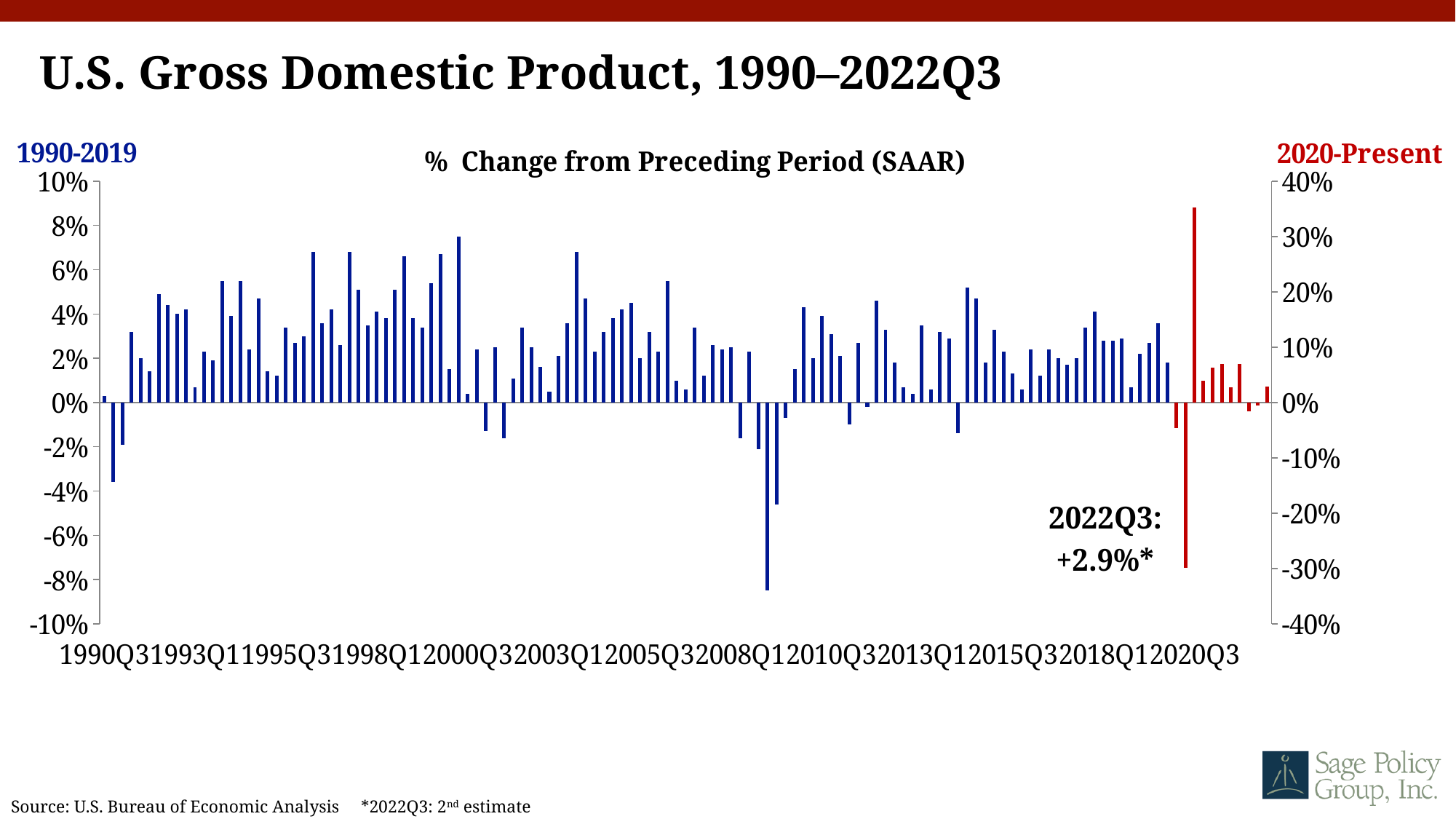
What is the GDP % change value labelled for 2022Q3? +2.9% What is the title of the slide's chart? % Change from Preceding Period (SAAR) Is the highest value in the 1990-2019 (blue) series greater or less than 6%? greater On the right-hand axis, is the lowest value in the 2020-Present (red) series greater or less than -20%? less Which colour represents the 2020-Present series? red What kind of chart is shown on the slide? bar chart Is the lowest value in the 1990-2019 (blue) series greater or less than -6%? less How many series does the chart show (as labelled above the axes)? 2